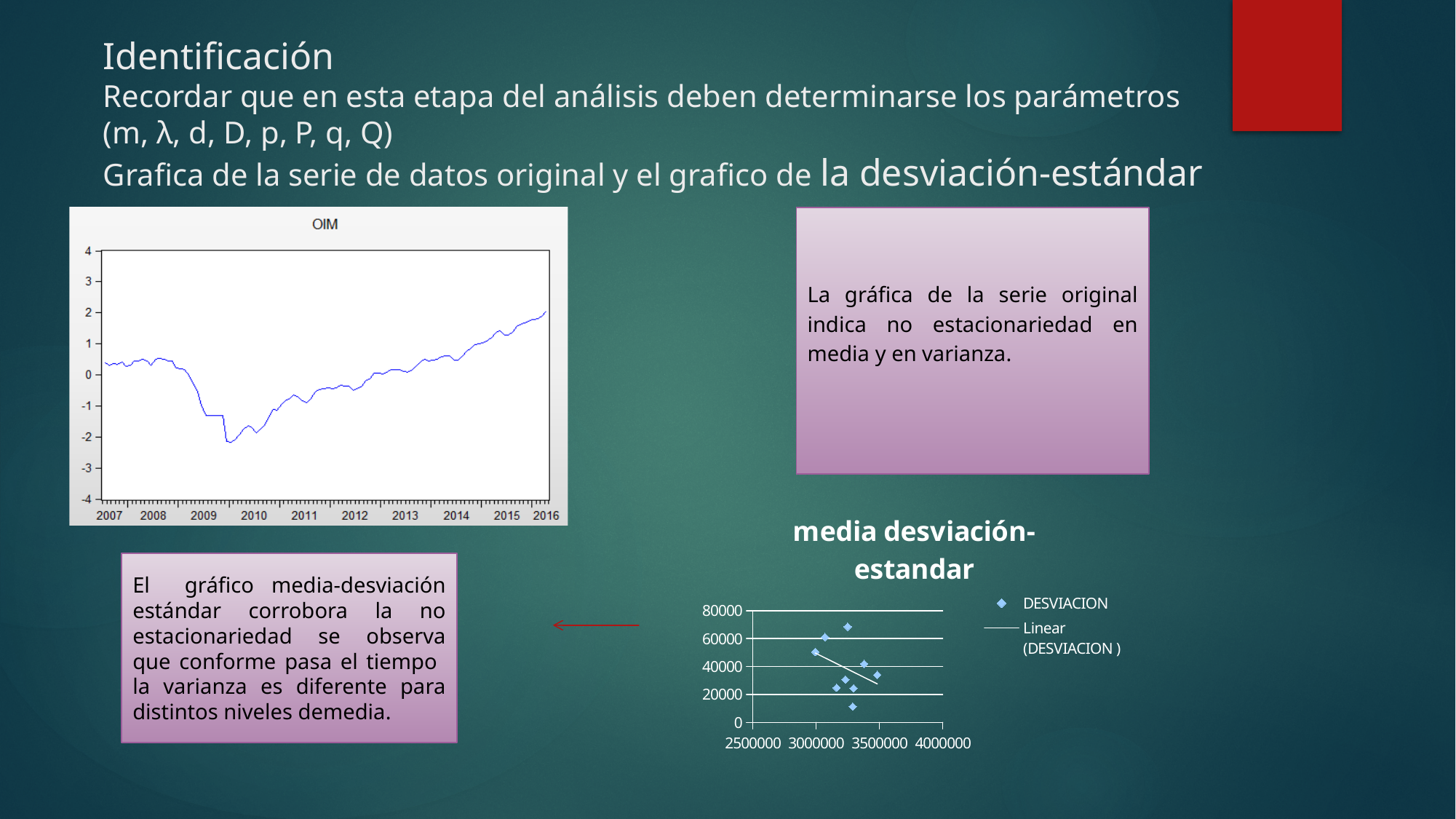
In the OIM chart, what is the highest value shown on the y axis? 4 In the 'media desviación-estandar' chart, what is the highest value shown on the y axis? 80000 In the OIM chart, is the lowest point of the series (around 2009-2010) greater or less than -1? less In the 'media desviación-estandar' chart, does the linear trendline rise or fall from left to right? fall What are the two legend entries of the 'media desviación-estandar' chart? DESVIACION and Linear (DESVIACION ) In the OIM chart, does the series rise or fall between 2010 and 2016? rise What kind of chart is the 'media desviación-estandar' chart on the right of the slide? scatter chart In the OIM chart, what is the first year shown on the x axis? 2007 In the OIM chart, is the value of the series at 2016 greater or less than 1? greater In the OIM chart, what is the last year shown on the x axis? 2016 What kind of chart is the OIM chart on the left of the slide? line chart How many series does the legend of the 'media desviación-estandar' chart list? 2